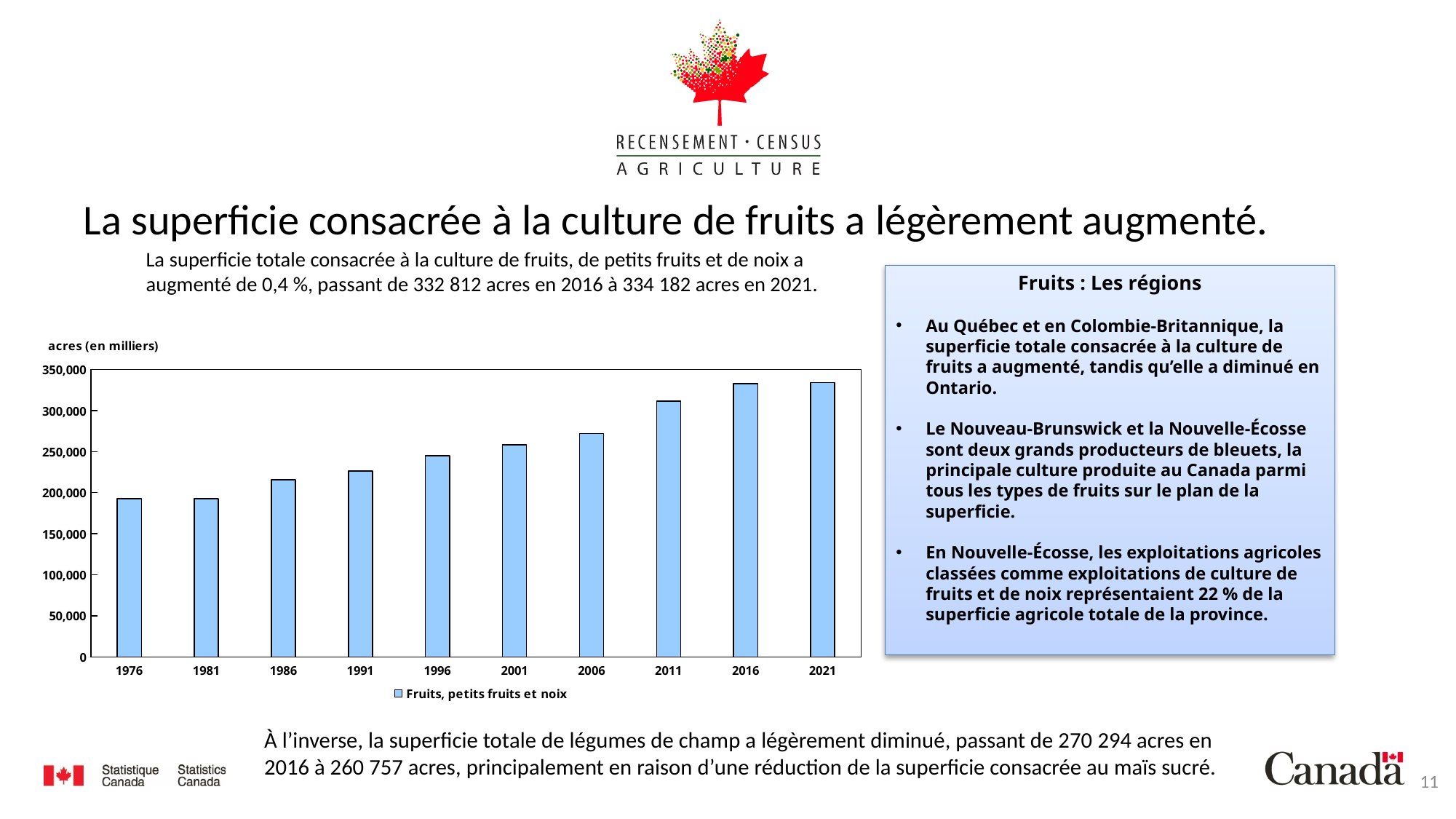
Is the value for 1996 greater or less than 250,000? less Is the value for 2011 greater or less than 300,000? greater How many years (bars) are plotted in the chart? 10 Which year has the larger value, 2006 or 2011? 2011 What is the series name shown in the chart legend? Fruits, petits fruits et noix How many series does the chart legend list? 1 What is the label of the vertical axis of the chart? acres (en milliers) Do the values in the chart generally rise or fall from 1976 to 2021? rise What kind of chart is shown on the slide? bar chart Which year has the larger value, 1986 or 1996? 1996 Is the value for 1976 greater or less than 200,000? less